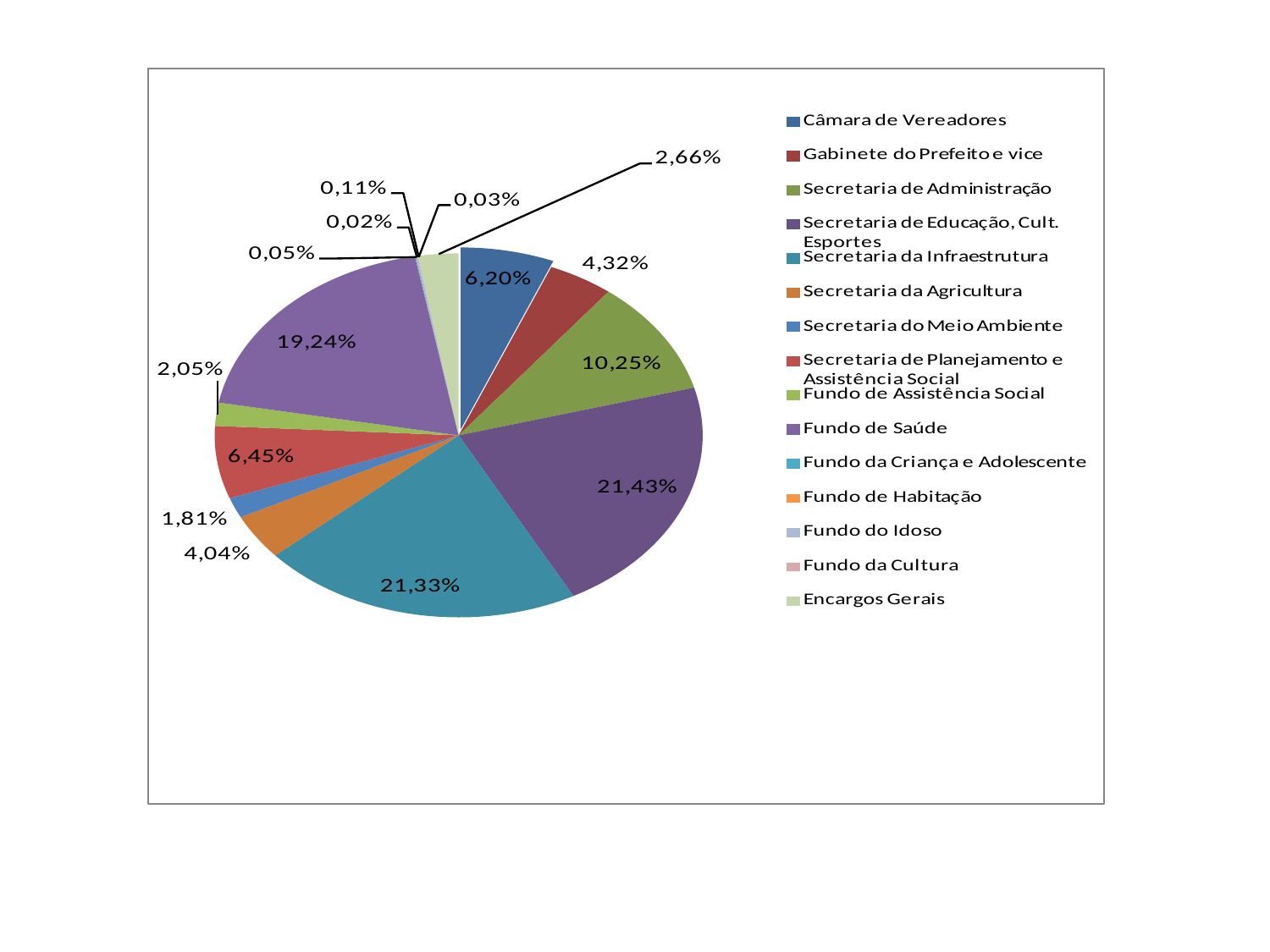
What percentage is shown for Câmara de Vereadores? 6,20% What is the difference between the shares for Secretaria de Administração and Gabinete do Prefeito e vice? 5,93% What kind of chart is shown on the slide? pie chart What percentage is shown for Encargos Gerais? 2,66% What colour is the slice for Secretaria da Infraestrutura? teal What percentage is shown for Secretaria de Educação, Cult. Esportes? 21,43% What percentage is shown for Secretaria da Infraestrutura? 21,33% What percentage is shown for Fundo de Saúde? 19,24% Which is larger, the share for Secretaria de Administração or the share for Secretaria de Planejamento e Assistência Social? Secretaria de Administração How many categories does the legend list? 15 Which category has the smallest share of the pie? Fundo de Habitação Which category has the largest share of the pie? Secretaria de Educação, Cult. Esportes